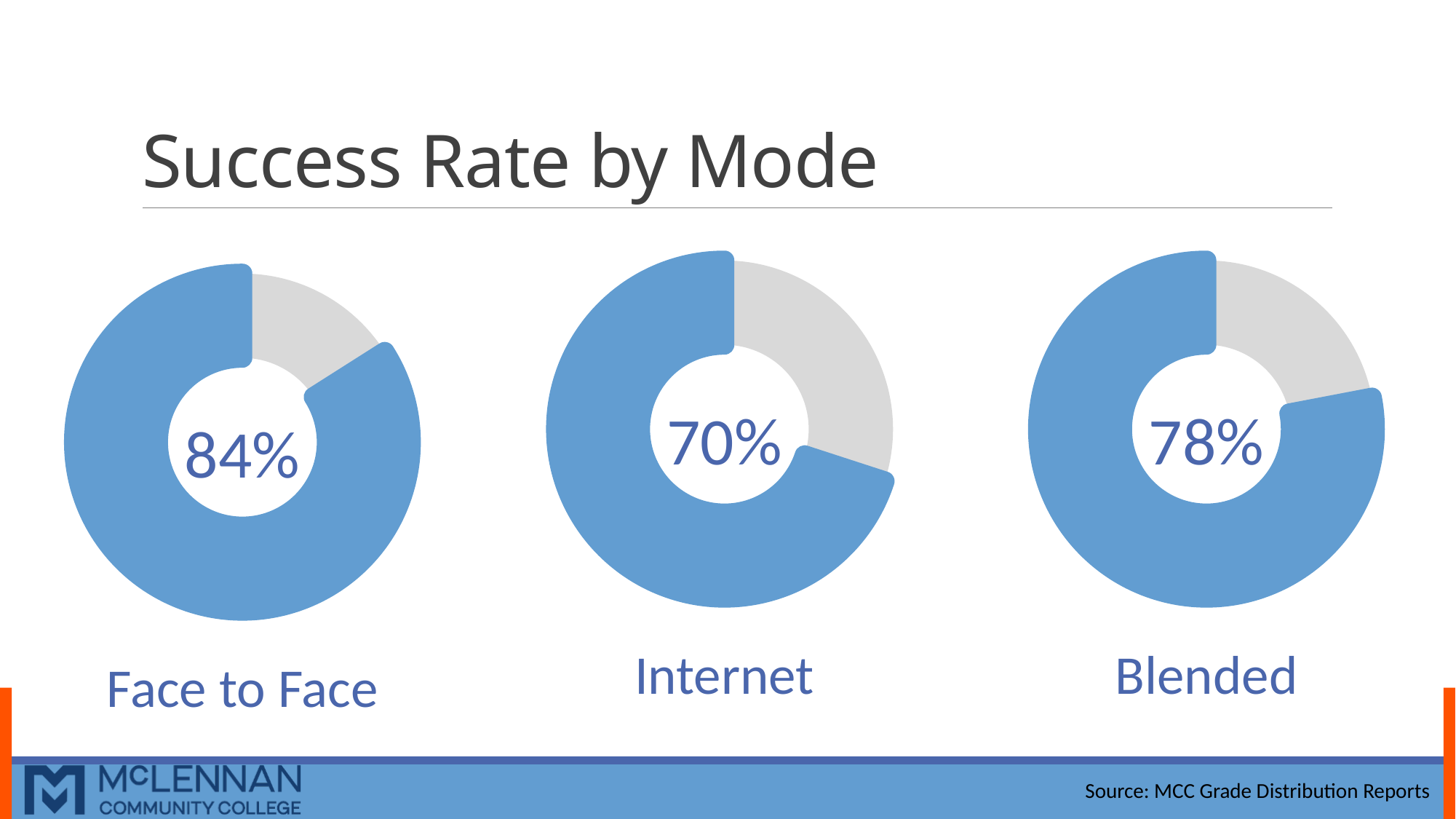
What is the success rate shown for the Internet mode? 70% What is the difference between the Blended and Internet success rates? 8% What is the success rate shown for the Face to Face mode? 84% What is the difference between the Face to Face and Internet success rates? 14% Which has a higher success rate, Blended or Internet? Blended What is the success rate shown for the Blended mode? 78% What kind of chart is used to show each success rate? Doughnut chart Which mode has the highest success rate? Face to Face How many modes are shown on the slide? 3 What is the source cited for the data on the slide? MCC Grade Distribution Reports Which mode has the lowest success rate? Internet What is the title of the slide? Success Rate by Mode